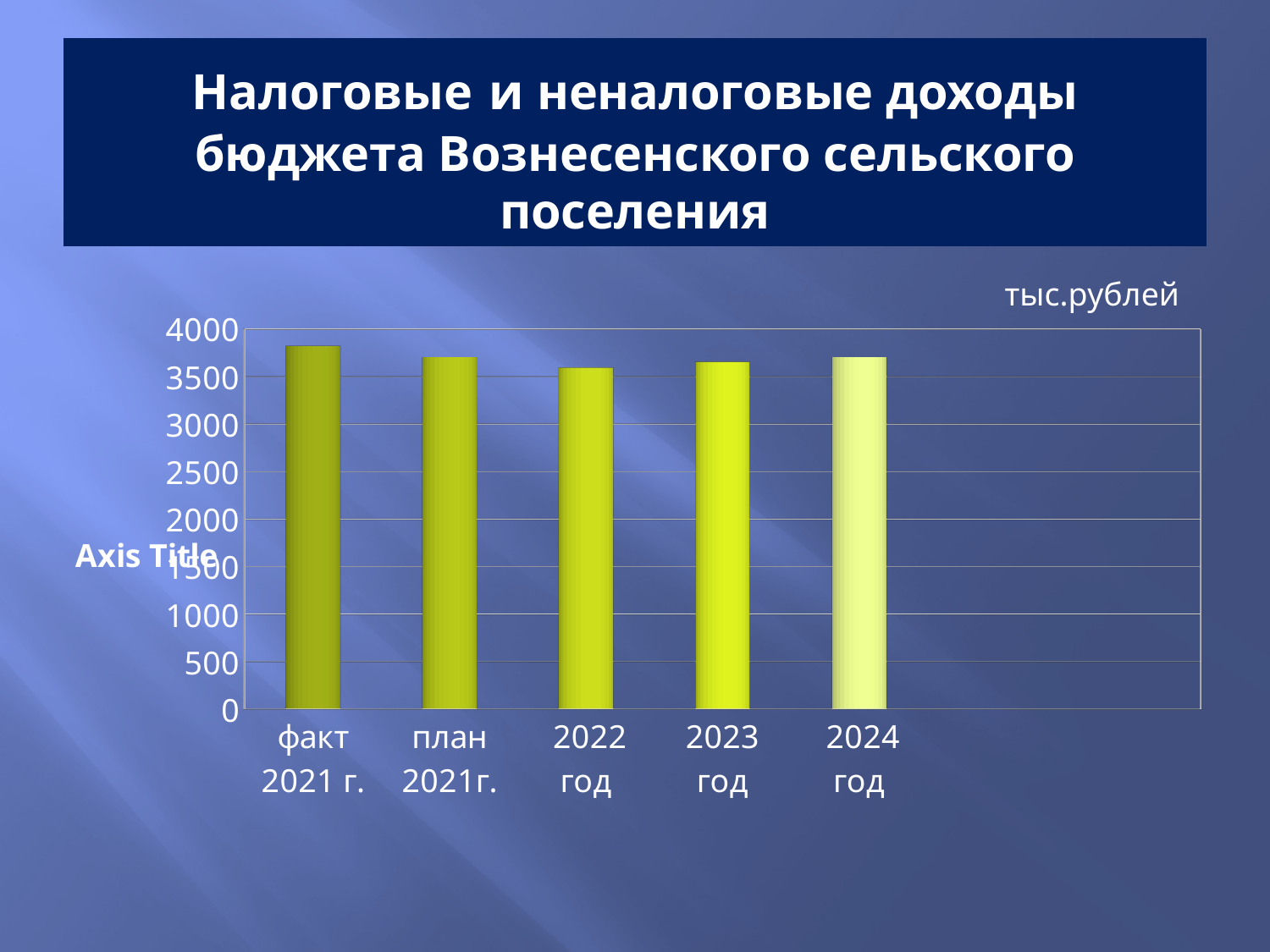
Which is larger, the value for факт 2021 г. or the value for 2022 год? факт 2021 г. Is the value for 2023 год greater or less than 3500? greater Is the value for факт 2021 г. greater or less than 3500? greater What unit label is shown above the chart? тыс.рублей Which category has the highest value on the chart? факт 2021 г. What is the title of the chart on the slide? Налоговые и неналоговые доходы бюджета Вознесенского сельского поселения What kind of chart is shown on the slide? bar chart How many categories (bars) are plotted on the chart? 5 Which is larger, the value for план 2021г. or the value for факт 2021 г.? факт 2021 г. Is the value for 2024 год greater or less than 3000? greater